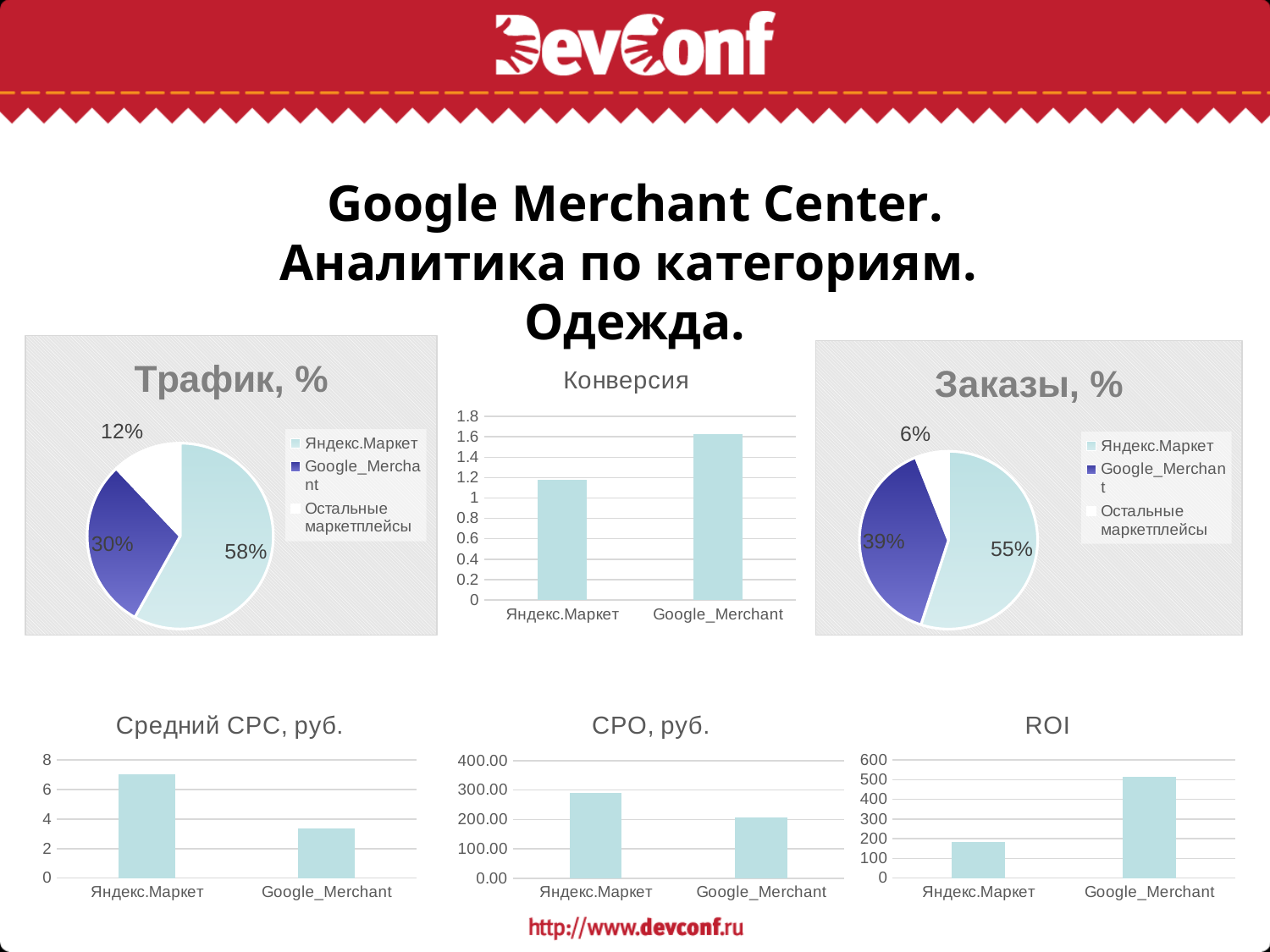
In the "Средний CPC, руб." chart, is the value for Яндекс.Маркет greater or less than 6? greater In the "Заказы, %" pie chart, which category has the smallest share? Остальные маркетплейсы In the "Заказы, %" pie chart, what share does Google_Merchant have? 39% How many entries does the legend of the "Трафик, %" chart list? 3 In the "CPO, руб." chart, which category has the lowest value? Google_Merchant In the "Трафик, %" pie chart, what share does Яндекс.Маркет have? 58% In the "Заказы, %" pie chart, what is the difference between the Яндекс.Маркет share and the Остальные маркетплейсы share? 49% In the "Трафик, %" pie chart, what is the difference between the Яндекс.Маркет share and the Google_Merchant share? 28% What kind of chart is the "ROI" chart? bar chart In the "Трафик, %" pie chart, what share does Google_Merchant have? 30% In the "Конверсия" chart, which category has the higher value, Яндекс.Маркет or Google_Merchant? Google_Merchant In the "ROI" chart, is the value for Google_Merchant greater or less than 400? greater